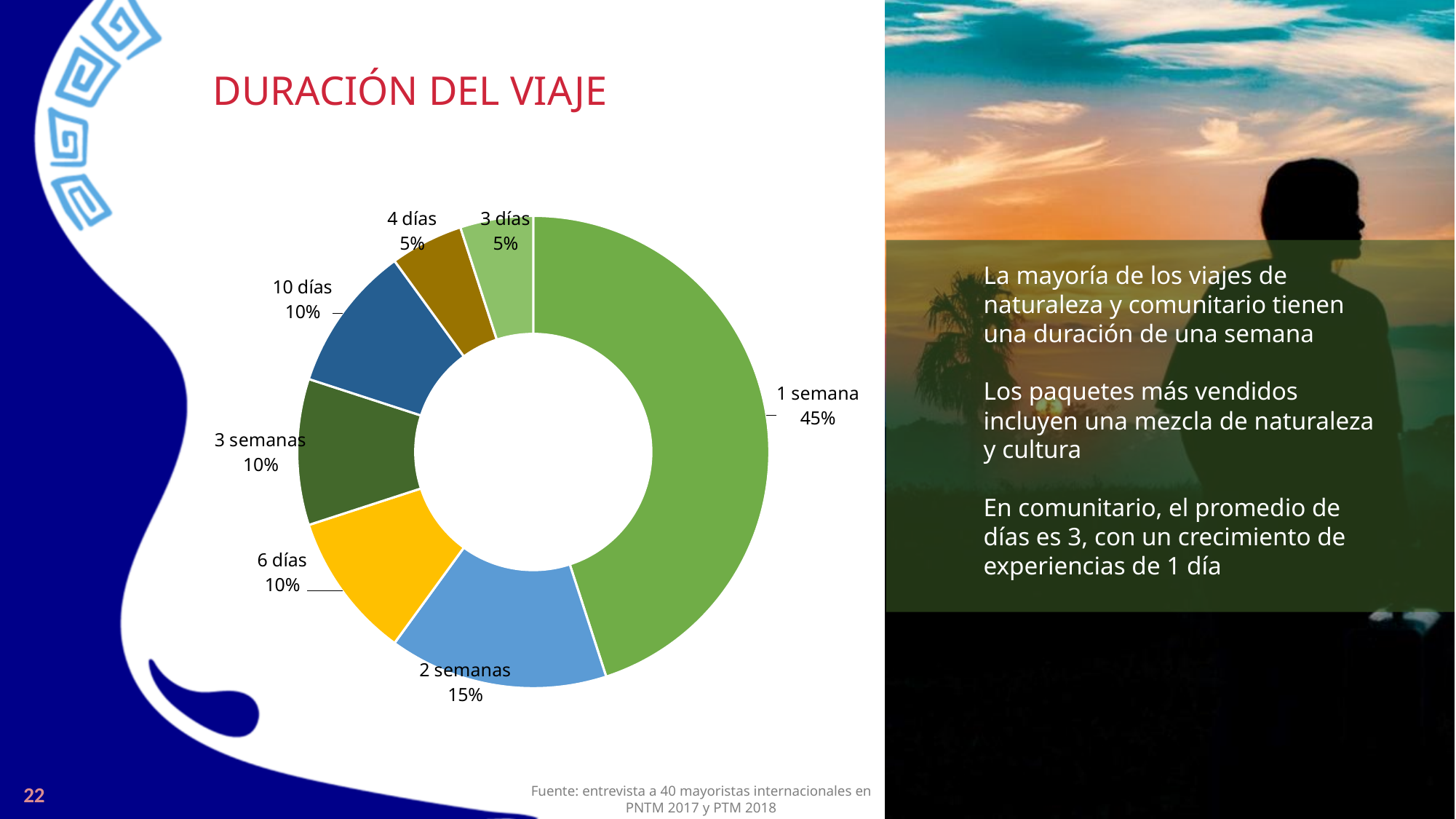
Which is larger, the share for "10 días" or the share for "4 días"? 10 días What is the title of the slide containing the chart? DURACIÓN DEL VIAJE What share of the chart does the "1 semana" slice represent? 45% How many categories are shown in the chart? 7 Which category has the largest share of the chart? 1 semana What is the value labelled for "3 días"? 5% What is the difference in percentage points between "1 semana" and "2 semanas"? 30 What percentage is shown for "6 días"? 10% What is the combined share of "3 semanas" and "2 semanas"? 25% What kind of chart is shown on the slide? Donut (pie) chart What colour is the "6 días" slice? Yellow What is the value shown for "2 semanas"? 15%